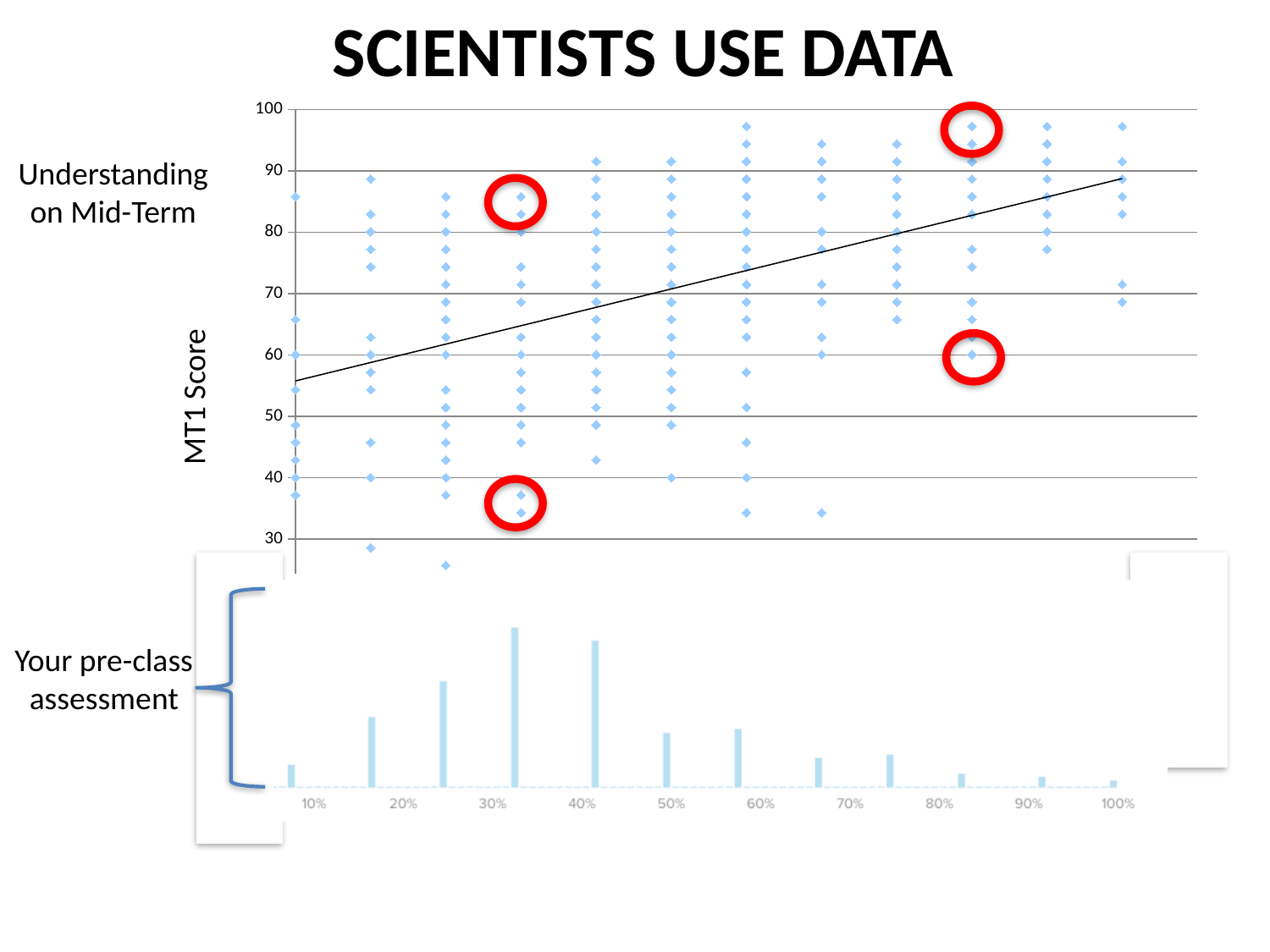
In the upper scatter plot, is the lowest red-circled point greater or less than 40? less In the lower bar chart, is the bar nearest 30% taller or shorter than the bar nearest 70%? taller In the upper scatter plot, what is the highest value shown on the vertical axis? 100 In the lower bar chart, how many bars are plotted? 12 In the upper scatter plot, what is the label on the vertical axis? MT1 Score In the upper scatter plot, does the fitted trend line rise or fall from left to right? rises In the upper scatter plot, is the highest red-circled point greater or less than 90? greater What kind of chart is the upper chart on the slide? scatter plot In the lower bar chart, what is the last tick label on the x axis? 100% In the lower bar chart, which labelled tick on the x axis is the tallest bar closest to? 30% What kind of chart is the lower chart on the slide? bar chart